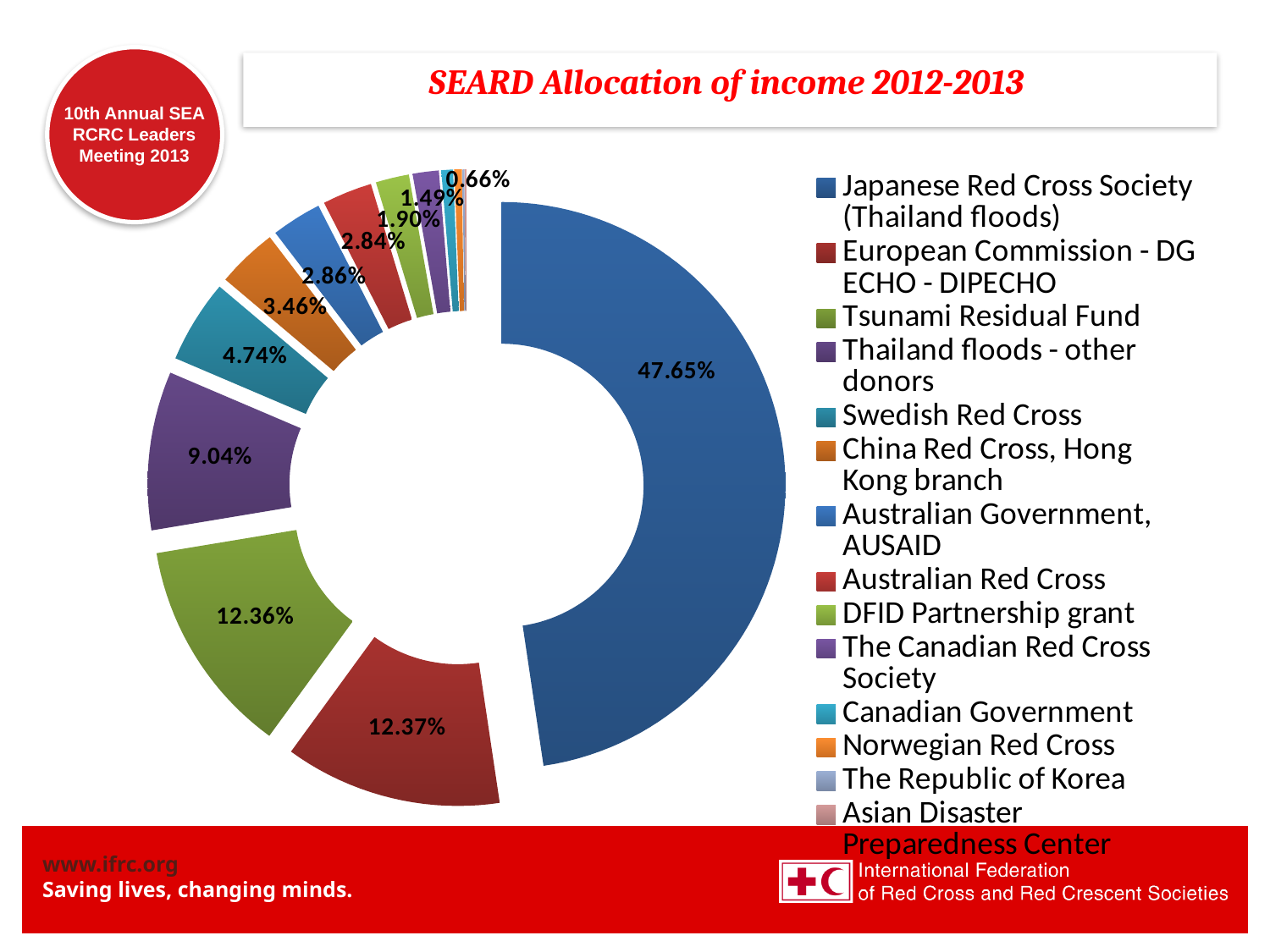
What percentage is shown for European Commission - DG ECHO - DIPECHO? 12.37% What is the title of the chart? SEARD Allocation of income 2012-2013 What share of income is allocated to the Japanese Red Cross Society (Thailand floods)? 47.65% What percentage is shown for the Tsunami Residual Fund? 12.36% Which has a larger share: the Swedish Red Cross or China Red Cross, Hong Kong branch? Swedish Red Cross What percentage is shown for Thailand floods - other donors? 9.04% How many percentage points larger is the Japanese Red Cross Society share than the European Commission - DG ECHO - DIPECHO share? 35.28% What percentage is shown for the Swedish Red Cross? 4.74% Which donor has the largest share of the allocation? Japanese Red Cross Society (Thailand floods) What kind of chart is shown on the slide? Doughnut (pie) chart How many donors are listed in the chart legend? 14 What is the difference between the Thailand floods - other donors share and the Swedish Red Cross share? 4.30%